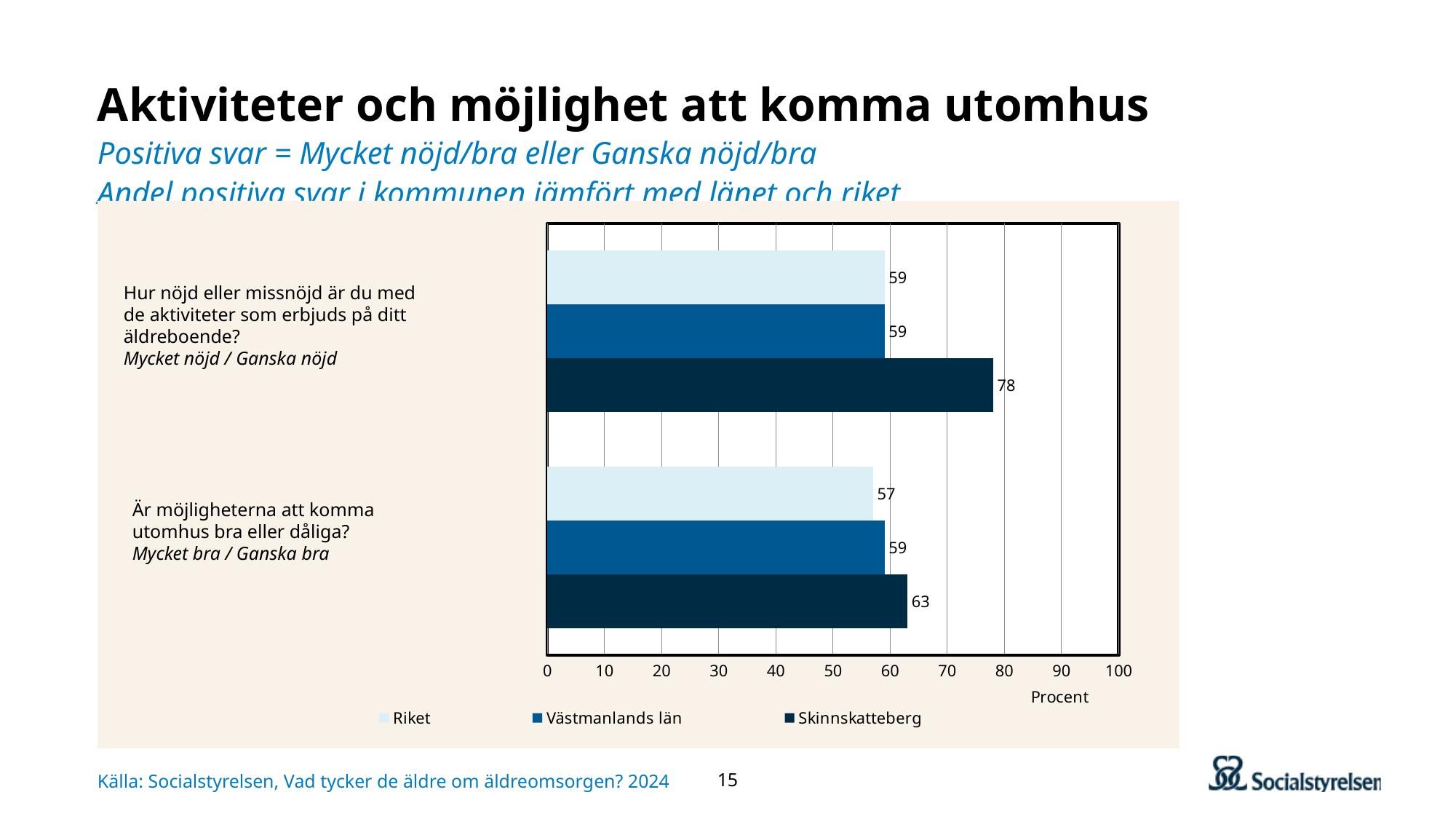
Which series has the lowest value on the question about opportunities to get outdoors? Riket What is the difference between Skinnskatteberg and Västmanlands län on the question about opportunities to get outdoors? 4 What is the value for Skinnskatteberg on the question about satisfaction with activities offered at the care home (Hur nöjd eller missnöjd är du med de aktiviteter som erbjuds på ditt äldreboende)? 78 What is the difference between Skinnskatteberg and Riket on the question about satisfaction with activities offered? 19 What kind of chart is shown on the slide? Bar chart What is the value for Riket on the question about opportunities to get outdoors (Är möjligheterna att komma utomhus bra eller dåliga)? 57 How many questions (categories) are shown on the chart? 2 Which is larger: Skinnskatteberg's value for the activities question or Skinnskatteberg's value for the outdoors question? Activities question (78) What is the value for Västmanlands län on the question about opportunities to get outdoors? 59 What is the label of the x axis? Procent Which series has the highest value on the question about satisfaction with activities offered? Skinnskatteberg How many series does the legend list? 3